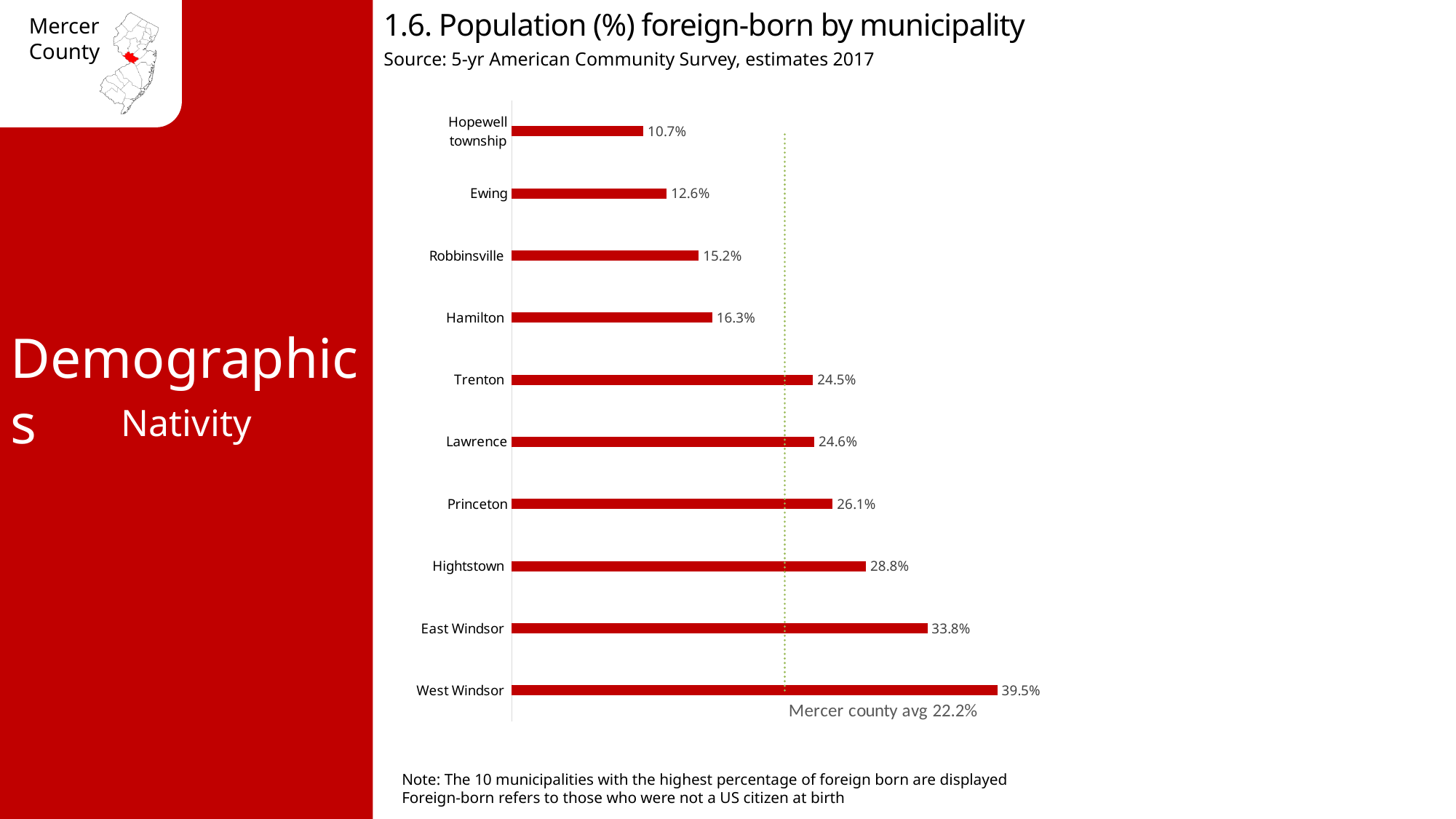
What is the difference in foreign-born percentage between Hightstown and Ewing? 16.2% Which has a higher foreign-born percentage, Robbinsville or Hamilton? Hamilton What is the foreign-born percentage shown for Princeton? 26.1% What is the source of the data shown in the chart? 5-yr American Community Survey, estimates 2017 Which municipality has the highest percentage of foreign-born population? West Windsor What is the Mercer county average foreign-born percentage indicated by the dotted line? 22.2% What is the difference in foreign-born percentage between West Windsor and East Windsor? 5.7% What is the foreign-born percentage shown for Hamilton? 16.3% What type of chart is used on this slide? Bar chart What percentage of the population is foreign-born in West Windsor? 39.5% How many municipalities are shown on the chart? 10 Which municipality has the lowest percentage of foreign-born population on the chart? Hopewell township